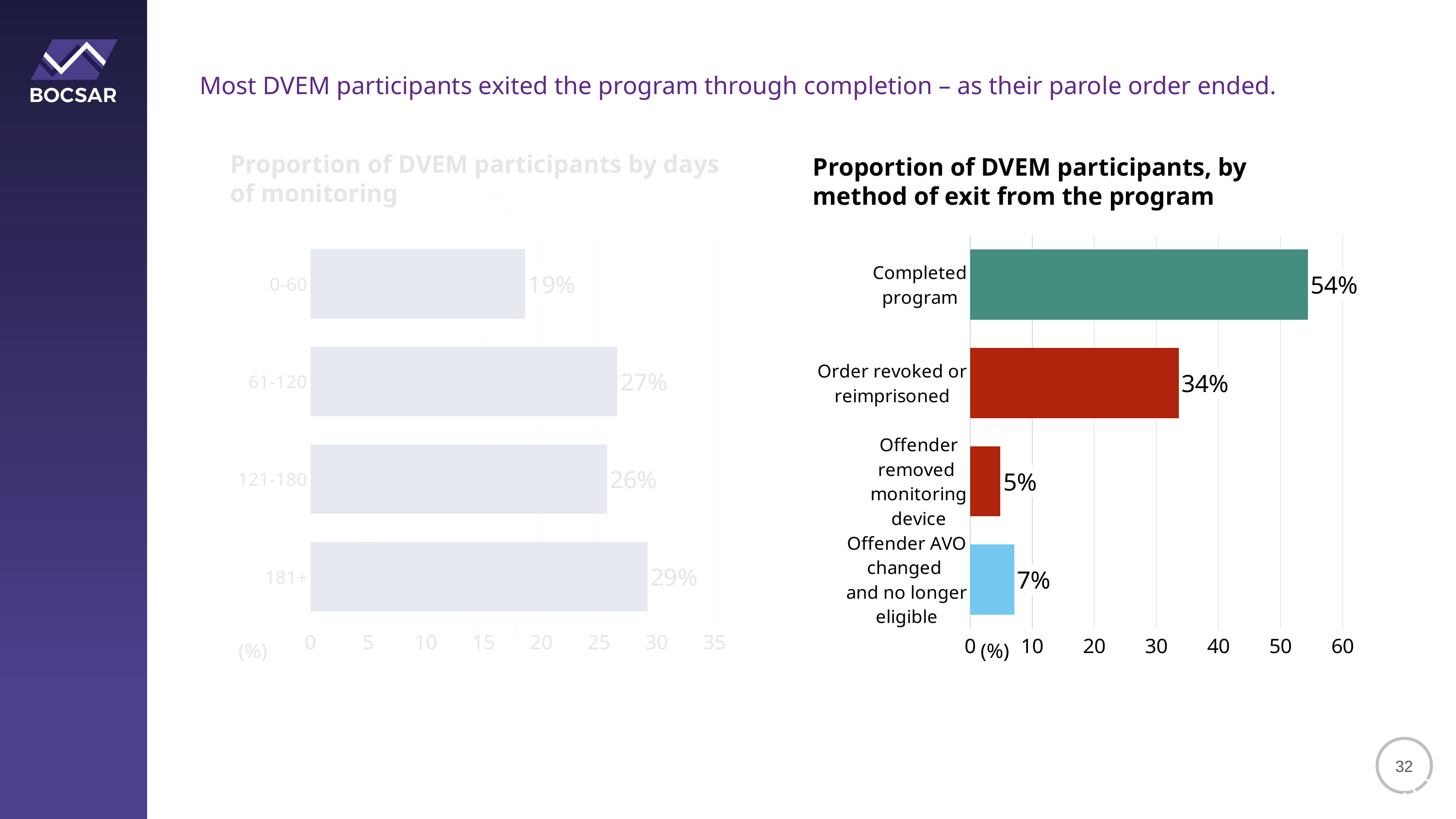
In the chart titled 'Proportion of DVEM participants, by method of exit from the program', which is larger: 'Offender removed monitoring device' or 'Offender AVO changed and no longer eligible'? Offender AVO changed and no longer eligible In the chart titled 'Proportion of DVEM participants, by method of exit from the program', which category has the lowest value? Offender removed monitoring device In the chart on the left, titled 'Proportion of DVEM participants by days of monitoring', which category has the lowest value? 0-60 In the chart titled 'Proportion of DVEM participants, by method of exit from the program', what is the value for 'Order revoked or reimprisoned'? 34% In the chart on the left, titled 'Proportion of DVEM participants by days of monitoring', what is the value for '181+'? 29% In the chart titled 'Proportion of DVEM participants, by method of exit from the program', what is the value for 'Completed program'? 54% In the chart titled 'Proportion of DVEM participants, by method of exit from the program', how many categories are shown? 4 In the chart titled 'Proportion of DVEM participants, by method of exit from the program', what is the difference between 'Completed program' and 'Order revoked or reimprisoned'? 20% In the chart titled 'Proportion of DVEM participants, by method of exit from the program', which category has the highest value? Completed program What kind of chart is the chart titled 'Proportion of DVEM participants, by method of exit from the program'? Bar chart In the chart titled 'Proportion of DVEM participants, by method of exit from the program', what is the value for 'Offender AVO changed and no longer eligible'? 7% In the chart titled 'Proportion of DVEM participants, by method of exit from the program', what colour is the bar for 'Completed program'? Teal green